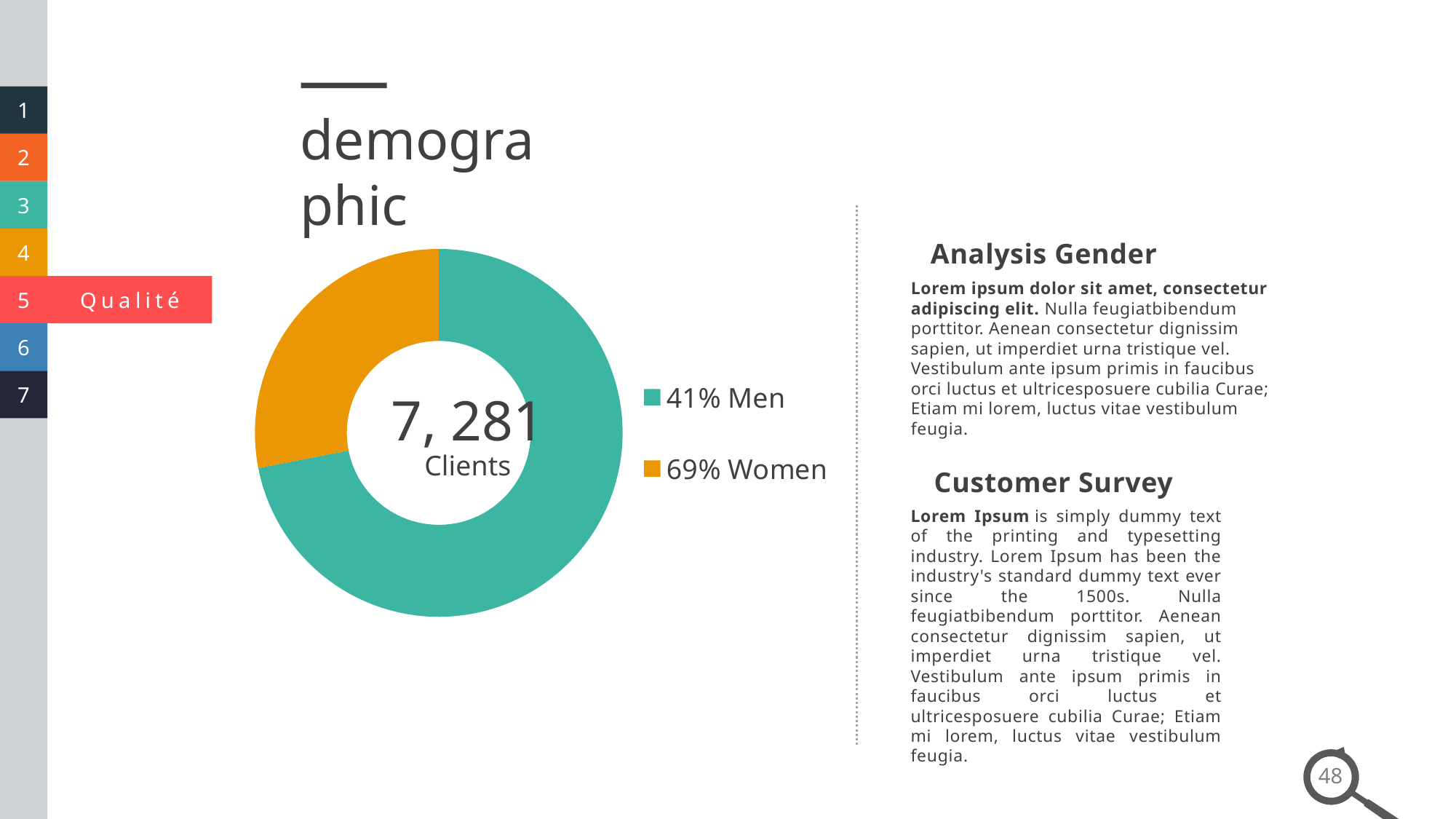
How many entries does the chart legend list? 2 According to the legend, what percentage is shown for Men? 41% What colour represents Women in the donut chart? Orange What colour represents Men in the donut chart? Teal According to the legend, what percentage is shown for Women? 69% What number is displayed in the centre of the donut chart? 7, 281 How many categories does the donut chart have? 2 What label appears under the number in the centre of the donut chart? Clients What kind of chart is shown on the slide? Donut (pie) chart